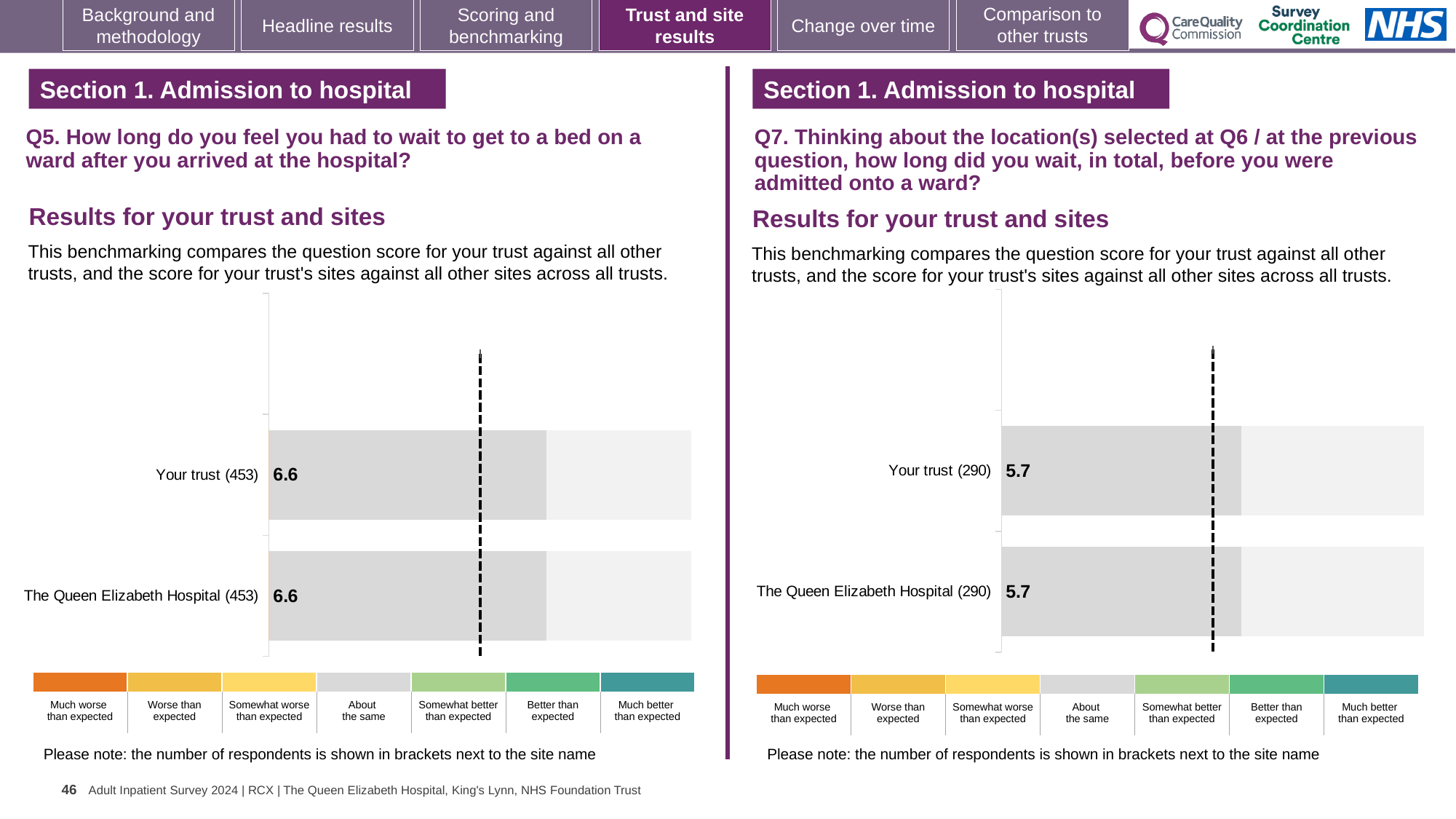
In the Q7 chart on the right, what is the score for The Queen Elizabeth Hospital? 5.7 In the Q7 chart on the right, what is the difference between the score for Your trust and the score for The Queen Elizabeth Hospital? 0 How many bars are plotted in the Q5 chart on the left? 2 In the Q7 chart on the right, what is the score for Your trust? 5.7 How many bars are plotted in the Q7 chart on the right? 2 In the Q5 chart on the left, what is the difference between the score for Your trust and the score for The Queen Elizabeth Hospital? 0 Is the score for Your trust in the Q5 chart on the left larger or smaller than the score for Your trust in the Q7 chart on the right? Larger In the Q5 chart on the left, what is the score for Your trust? 6.6 In the Q7 chart on the right, how many respondents are shown in brackets next to The Queen Elizabeth Hospital? 290 In the Q5 chart on the left, what is the score for The Queen Elizabeth Hospital? 6.6 What kind of chart is the Q5 chart on the left? Bar chart In the Q5 chart on the left, how many respondents are shown in brackets next to Your trust? 453